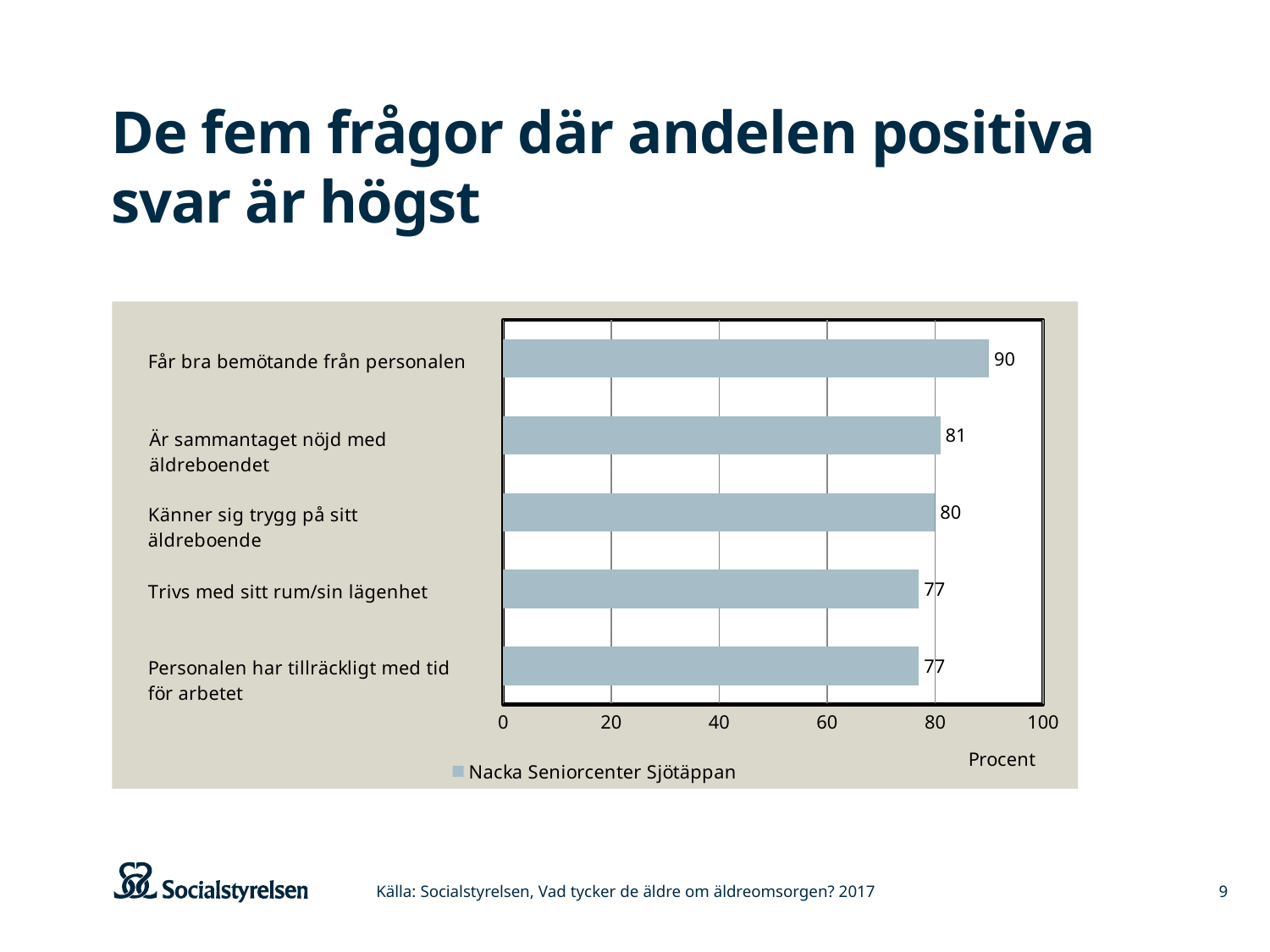
What is the value for "Får bra bemötande från personalen"? 90 Is the value for "Får bra bemötande från personalen" greater or less than 80? greater What is the value for "Är sammantaget nöjd med äldreboendet"? 81 Which is larger: the value for "Är sammantaget nöjd med äldreboendet" or the value for "Trivs med sitt rum/sin lägenhet"? Är sammantaget nöjd med äldreboendet Which category has the highest value? Får bra bemötande från personalen What is the value for "Känner sig trygg på sitt äldreboende"? 80 How many series does the legend list? 1 What is the value for "Personalen har tillräckligt med tid för arbetet"? 77 What kind of chart is shown on the slide? bar chart How many categories are shown in the chart? 5 What is the difference between the values for "Får bra bemötande från personalen" and "Trivs med sitt rum/sin lägenhet"? 13 What series name is shown in the legend? Nacka Seniorcenter Sjötäppan